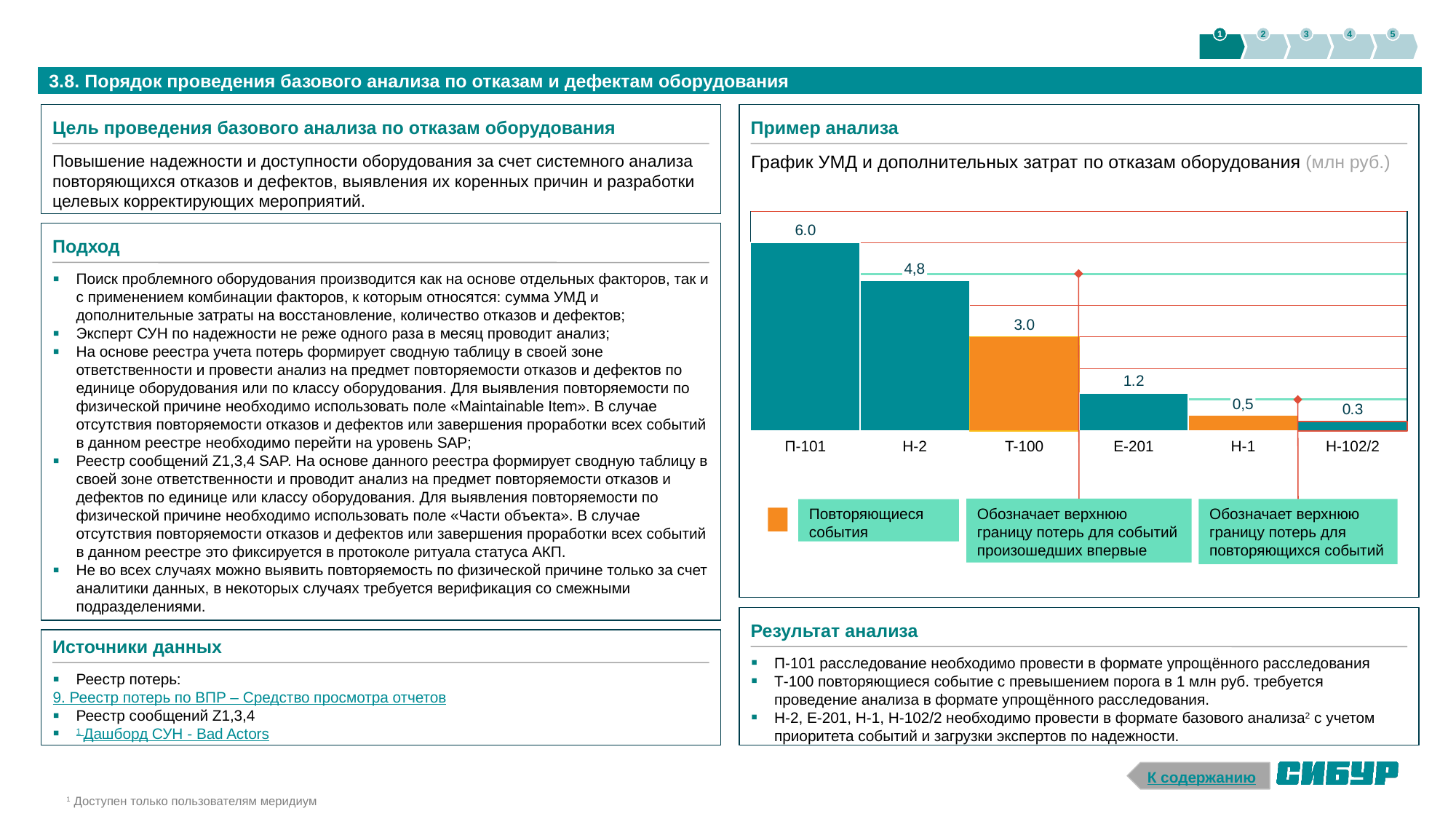
What is the value for Н-2? 4,8 What is the value for Н-1? 0,5 What is the value for П-101? 6.0 What kind of chart is shown on the slide? Bar chart What is the difference between the values for Т-100 and Е-201? 1.8 Which category has the highest value? П-101 What is the difference between the values for П-101 and Т-100? 3.0 Which category has the lowest value? Н-102/2 Which is larger, the value for Е-201 or the value for Н-1? Е-201 Which categories are shown in orange as repeating events (Повторяющиеся события)? Т-100 and Н-1 What is the value for Т-100? 3.0 How many categories are shown on the chart? 6